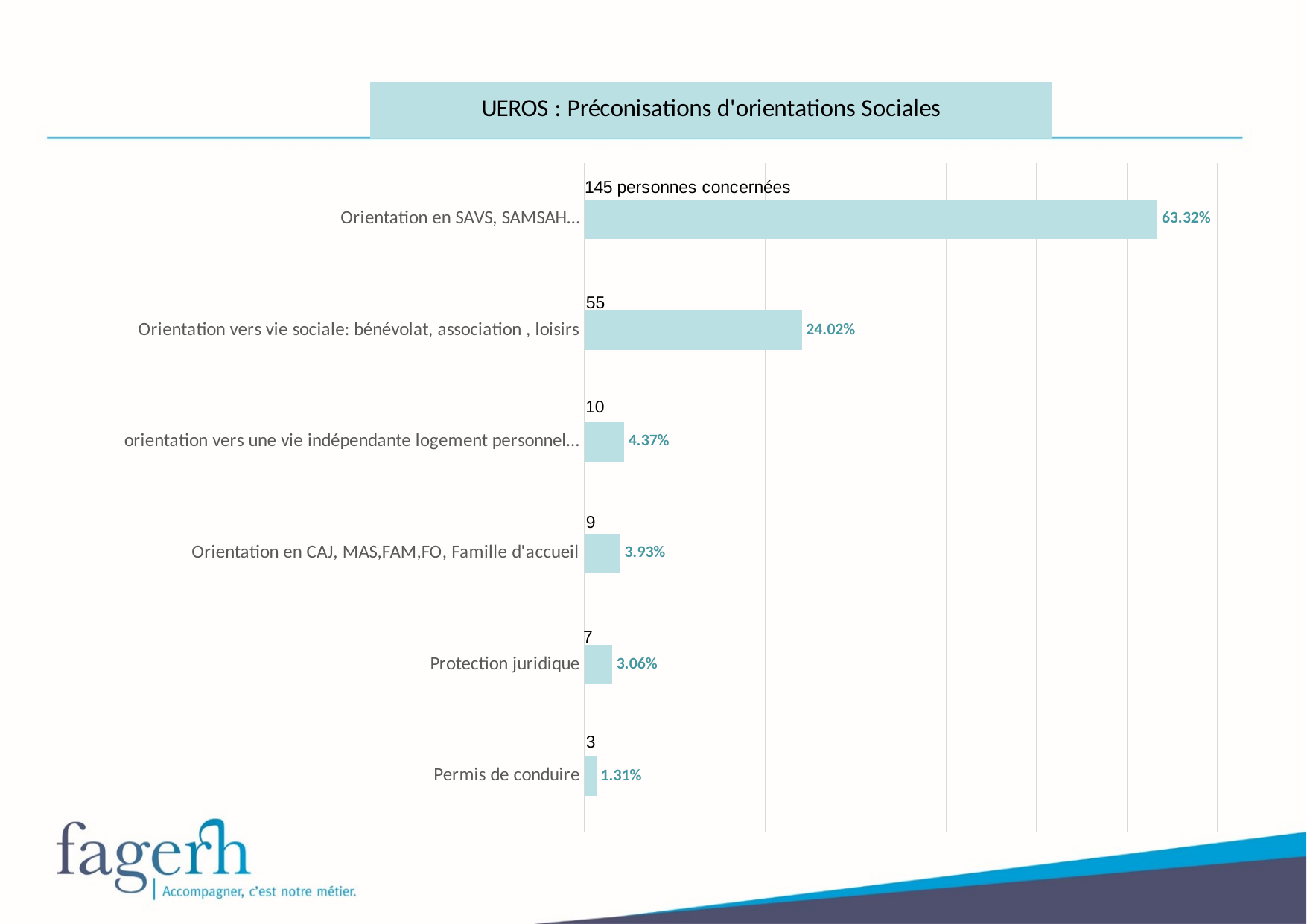
What percentage is shown for Orientation vers vie sociale: bénévolat, association, loisirs? 24.02% What is the title of the chart? UEROS : Préconisations d'orientations Sociales Which category has the highest value? Orientation en SAVS, SAMSAH... Which is larger: the value for orientation vers une vie indépendante logement personnel... or the value for Protection juridique? orientation vers une vie indépendante logement personnel... What percentage is shown for Protection juridique? 3.06% What is the difference in percentage points between Orientation en CAJ, MAS,FAM,FO, Famille d'accueil and Permis de conduire? 2.62 How many people are shown for Permis de conduire? 3 How many people are shown for Orientation en CAJ, MAS,FAM,FO, Famille d'accueil? 9 How many categories are shown in the chart? 6 What is the difference in number of people between Orientation en SAVS, SAMSAH... and Orientation vers vie sociale: bénévolat, association, loisirs? 90 Which category has the lowest value? Permis de conduire What kind of chart is shown on the slide? Bar chart